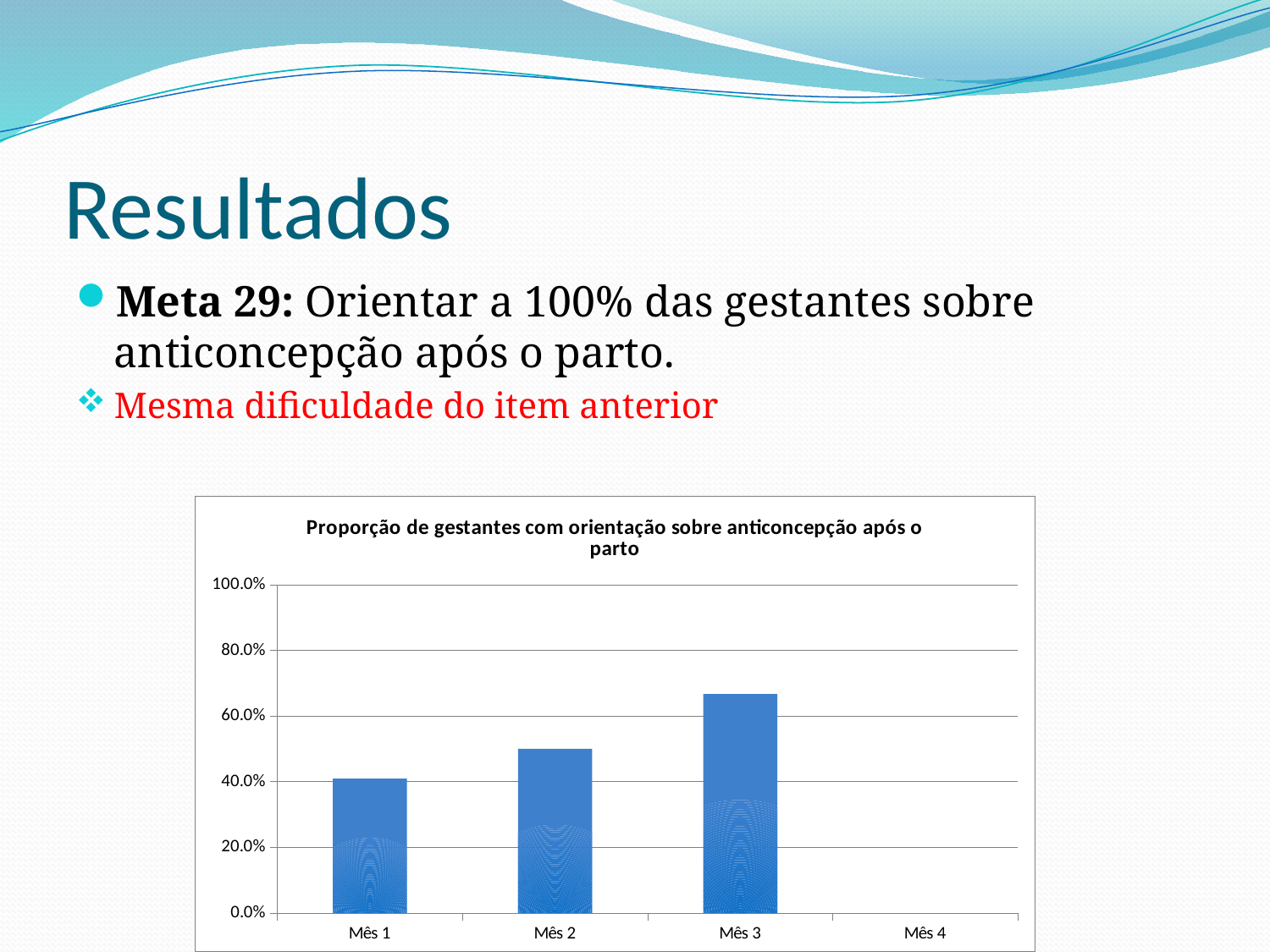
Is the value for Mês 1 greater or less than 20.0%? greater How many categories are shown on the x axis of the chart? 4 What is the title of the chart? Proporção de gestantes com orientação sobre anticoncepção após o parto Which is larger, the value for Mês 2 or the value for Mês 1? Mês 2 Which is larger, the value for Mês 1 or the value for Mês 3? Mês 3 Is the value for Mês 2 greater or less than 60.0%? less Is the value for Mês 3 greater or less than 80.0%? less What kind of chart is shown on the slide? bar chart Do the bar values rise or fall from Mês 1 to Mês 3? rise Which month has the highest bar in the chart? Mês 3 What is the highest value shown on the vertical axis of the chart? 100.0%